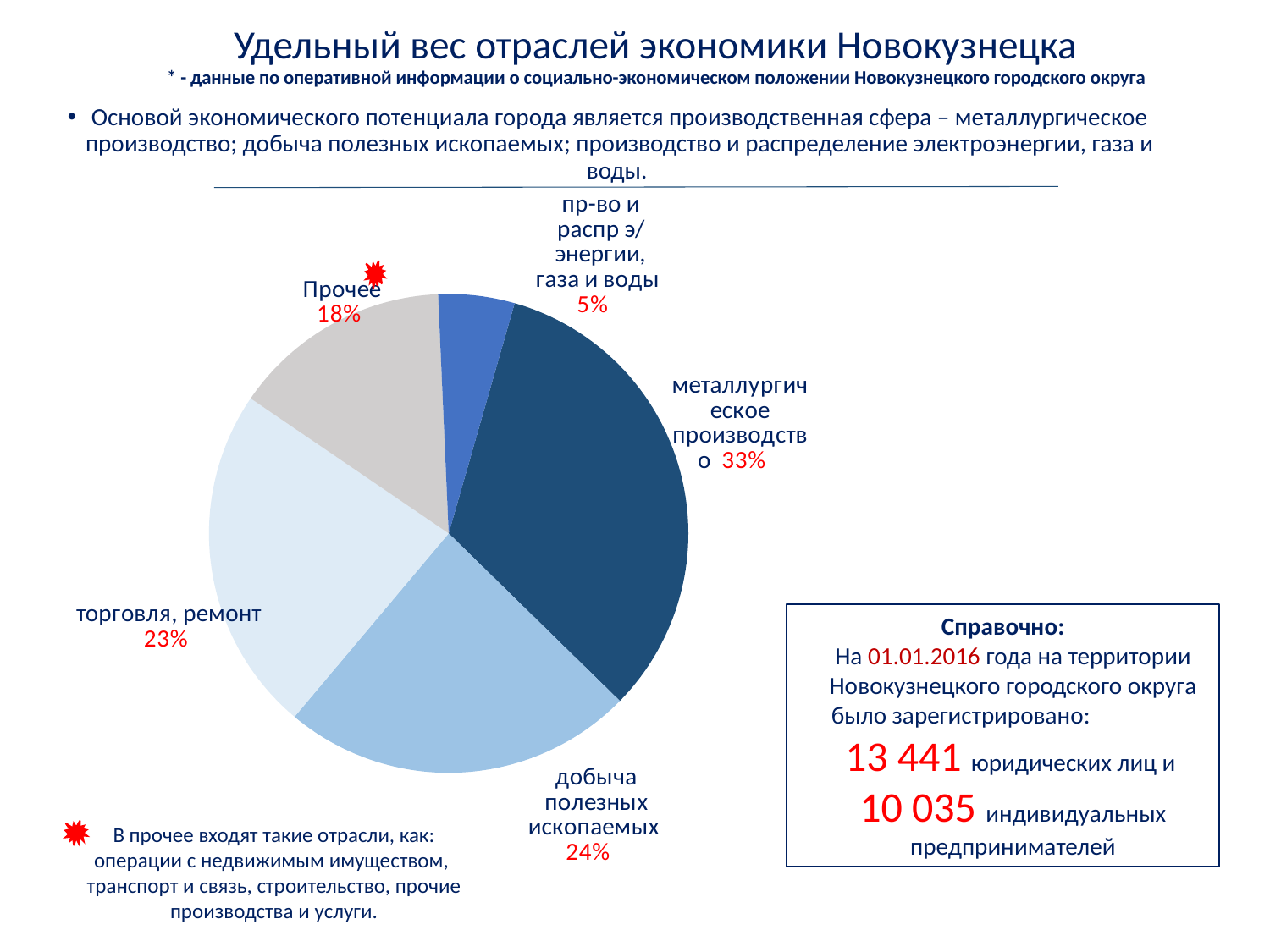
What is the value shown for пр-во и распр э/энергии, газа и воды? 5% What is the difference between the shares of металлургическое производство and Прочее? 15% What is the title of the chart on the slide? Удельный вес отраслей экономики Новокузнецка What is the value shown for торговля, ремонт? 23% What is the value shown for добыча полезных ископаемых? 24% What share of the pie does металлургическое производство have? 33% Which is larger, the share of добыча полезных ископаемых or the share of Прочее? добыча полезных ископаемых What kind of chart is shown on the slide? pie chart How many slices does the pie chart have? 5 Which sector has the largest share of the pie? металлургическое производство Which sector has the smallest share of the pie? пр-во и распр э/энергии, газа и воды What is the value shown for Прочее? 18%